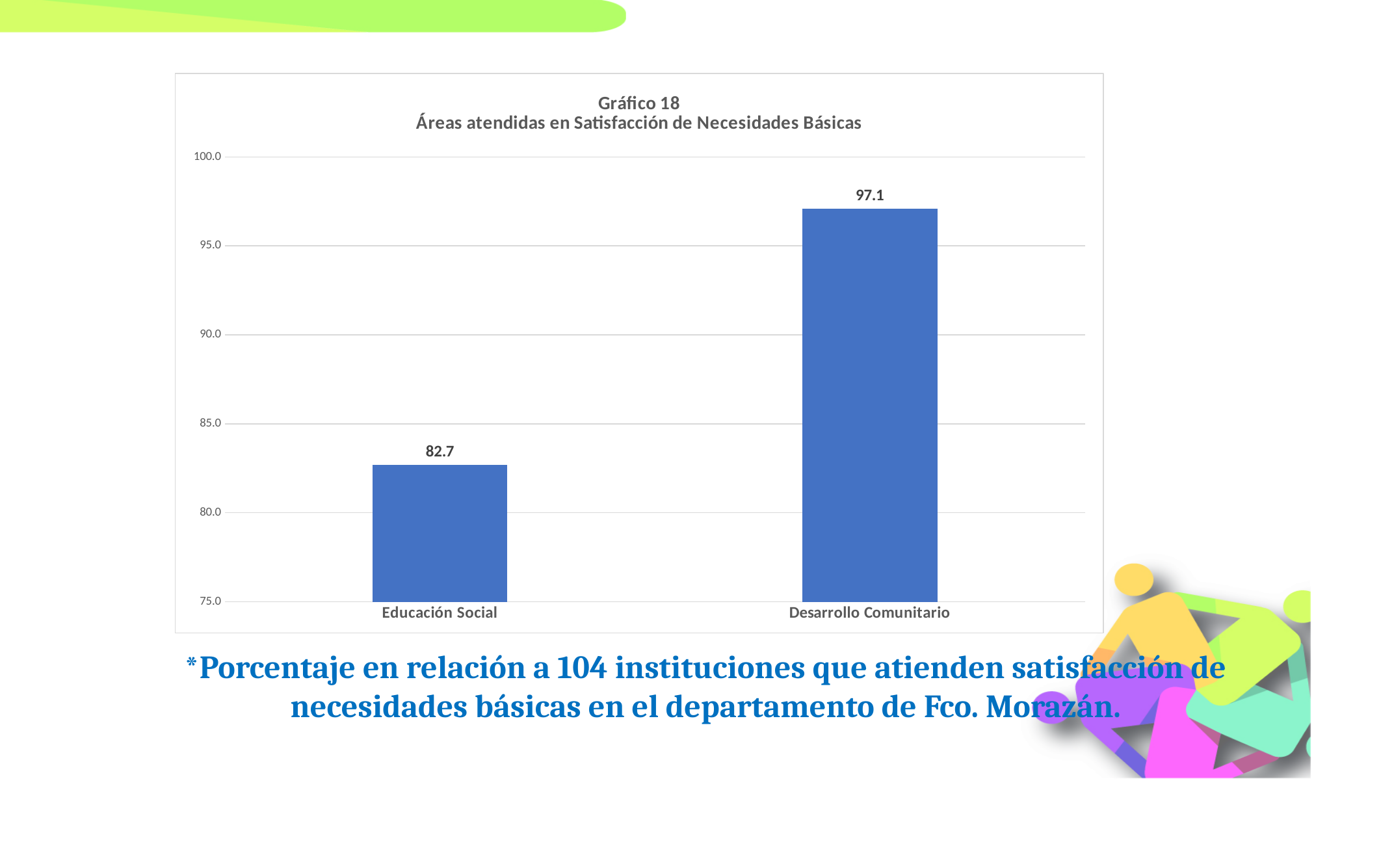
Which category has the lowest value? Educación Social Is the value for Educación Social greater or less than 85.0? less Is the value for Desarrollo Comunitario greater or less than 95.0? greater What is the value for Educación Social? 82.7 What is the title of the chart? Gráfico 18 Áreas atendidas en Satisfacción de Necesidades Básicas Which is larger, the value for Educación Social or the value for Desarrollo Comunitario? Desarrollo Comunitario What is the difference between the values for Desarrollo Comunitario and Educación Social? 14.4 What is the value for Desarrollo Comunitario? 97.1 How many categories are shown on the chart? 2 What is the lowest value shown on the vertical axis? 75.0 What kind of chart is shown on the slide? bar chart Which category has the highest value? Desarrollo Comunitario